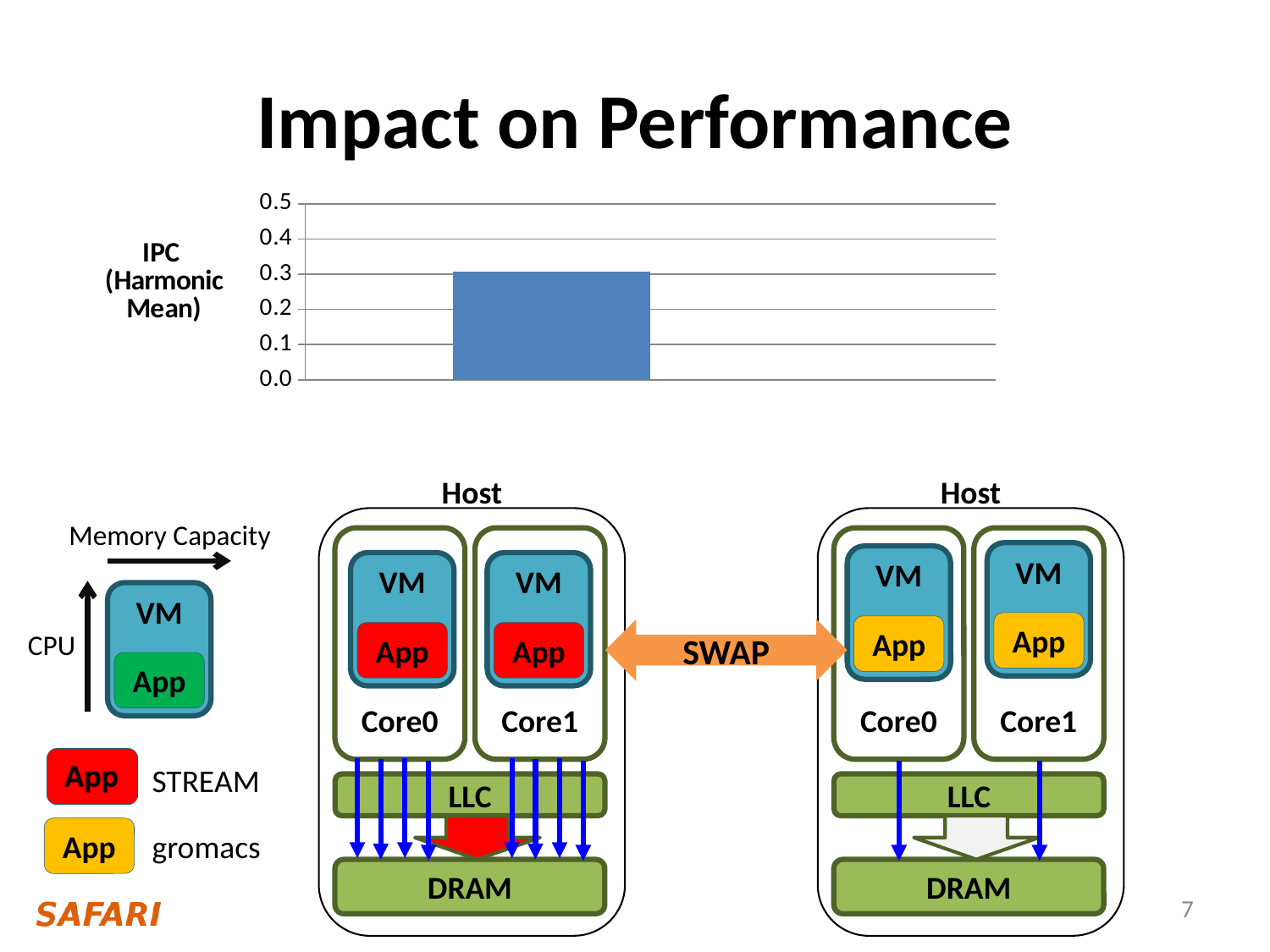
What kind of chart is shown on the slide? bar chart What is the highest value shown on the vertical axis of the chart? 0.5 What is the label of the vertical axis of the chart? IPC (Harmonic Mean) Is the value of the single bar in the chart greater or less than 0.2? greater Is the value of the single bar in the chart greater or less than 0.5? less Is the value of the single bar in the chart greater or less than 0.4? less How many bars are plotted in the chart? 1